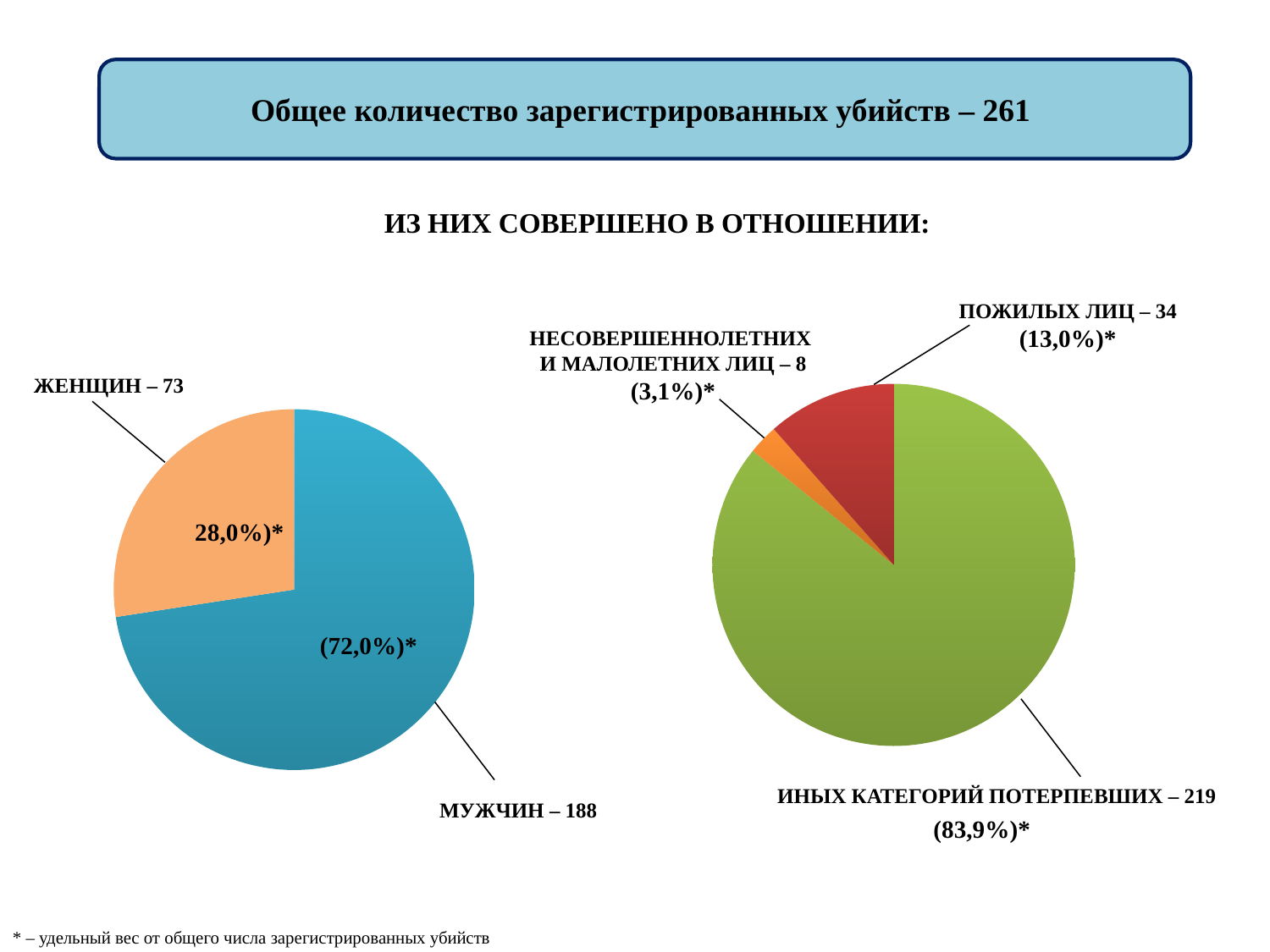
On the right pie chart, which category has the largest value? ИНЫХ КАТЕГОРИЙ ПОТЕРПЕВШИХ On the left pie chart, what share of the total do murders of men (МУЖЧИН) represent? 72,0% On the right pie chart, how many categories are shown? 3 On the right pie chart, what is the difference between the number of murders of other categories of victims (ИНЫХ КАТЕГОРИЙ ПОТЕРПЕВШИХ) and of elderly persons (ПОЖИЛЫХ ЛИЦ)? 185 On the left pie chart, which category has the larger value, ЖЕНЩИН or МУЖЧИН? МУЖЧИН On the right pie chart, how many murders were committed against elderly persons (ПОЖИЛЫХ ЛИЦ)? 34 On the left pie chart, how many murders were committed against women (ЖЕНЩИН)? 73 What total number of registered murders is stated in the header box at the top of the slide? 261 On the left pie chart, what is the difference between the number of murders of men and of women? 115 On the right pie chart, which category has the smallest value? НЕСОВЕРШЕННОЛЕТНИХ И МАЛОЛЕТНИХ ЛИЦ What type of chart is used on the left side of the slide? Pie chart On the right pie chart, what share of the total do murders of minors and young children (НЕСОВЕРШЕННОЛЕТНИХ И МАЛОЛЕТНИХ ЛИЦ) represent? 3,1%